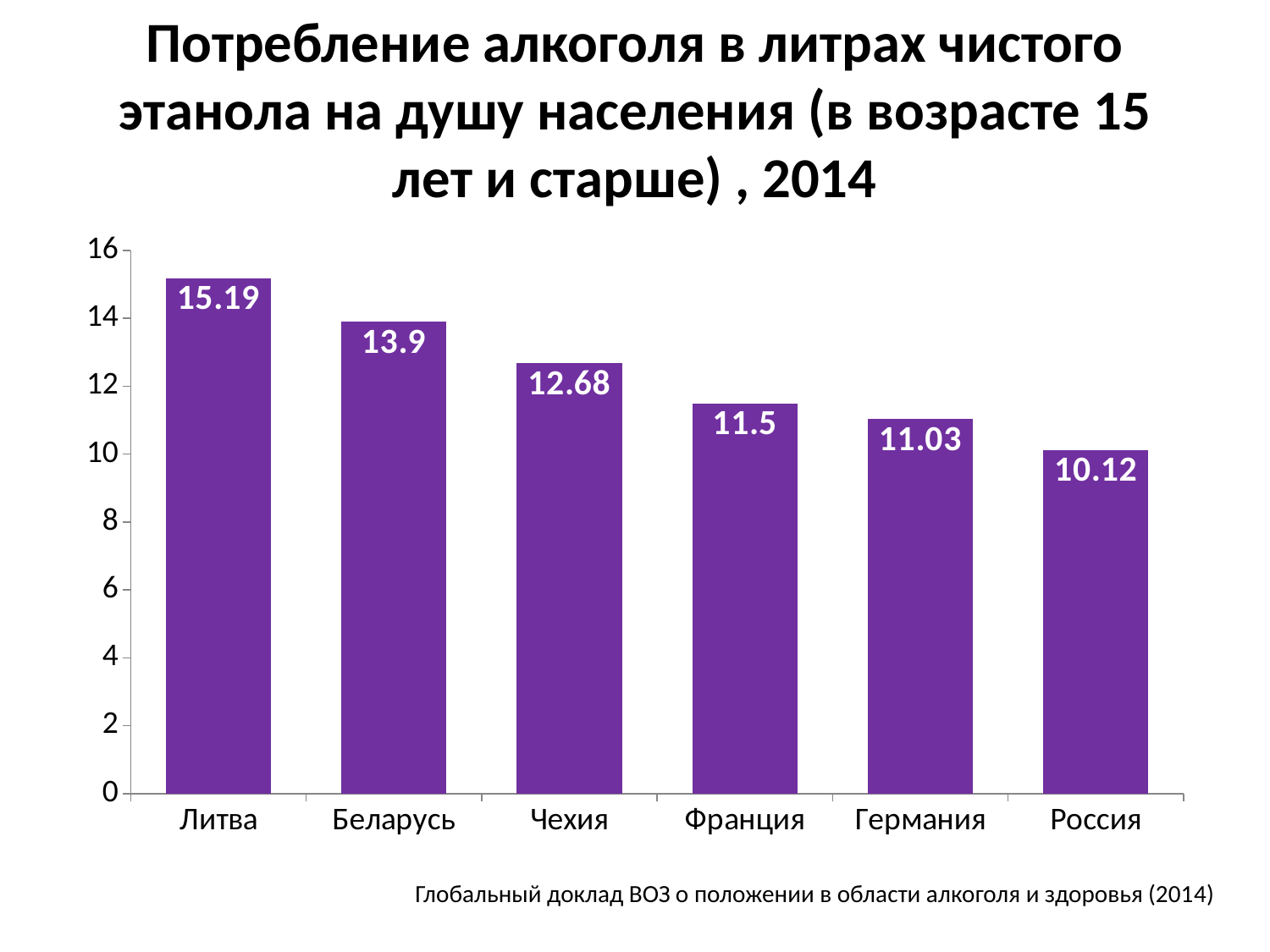
What is the value for Россия? 10.12 What is the difference between the values for Литва and Беларусь? 1.29 How many countries are shown on the chart? 6 Which country has the lowest value? Россия Which is larger, the value for Франция or the value for Германия? Франция What is the value for Литва? 15.19 What is the difference between the values for Чехия and Россия? 2.56 Which country has the highest value? Литва What kind of chart is this? bar chart Is the value for Беларусь greater or less than 14? less What is the value for Германия? 11.03 Do the values rise or fall from left to right along the x axis? fall